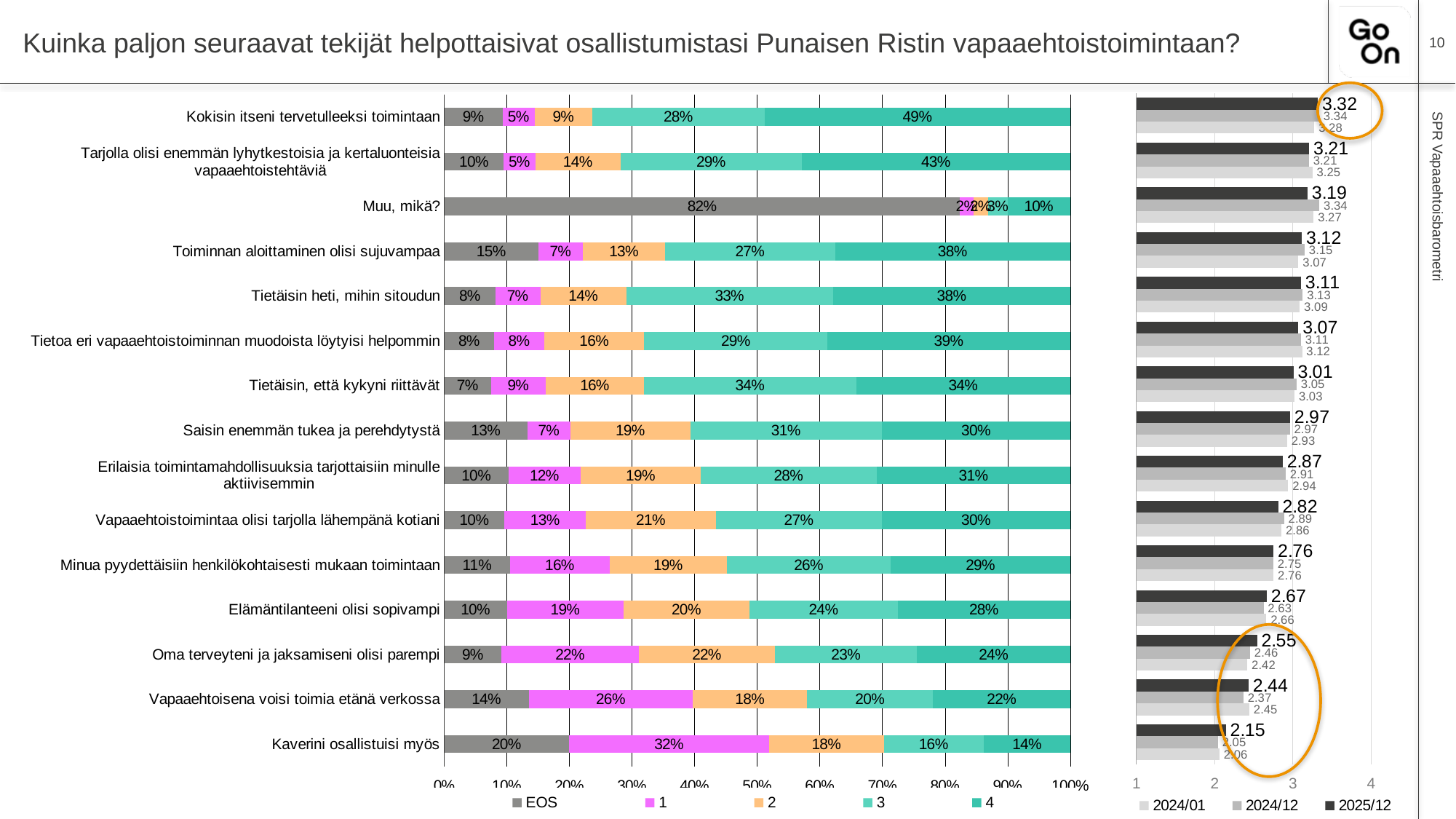
In the left stacked bar chart, what percentage of respondents gave a rating of 4 for "Kokisin itseni tervetulleeksi toimintaan"? 49% In the left stacked bar chart, which category has the highest share of rating 4? Kokisin itseni tervetulleeksi toimintaan What kind of chart is the left chart on the slide? Stacked bar chart In the right bar chart, which category has the lowest 2025/12 value? Kaverini osallistuisi myös In the left stacked bar chart, what percentage gave a rating of 1 for "Kaverini osallistuisi myös"? 32% In the right bar chart, what is the 2025/12 value for "Kokisin itseni tervetulleeksi toimintaan"? 3.32 How many series does the legend of the left stacked bar chart list? 5 How many categories are shown in the left stacked bar chart? 15 In the left stacked bar chart, for "Kaverini osallistuisi myös", which is larger: the share of rating 1 or the share of rating 4? Rating 1 In the left stacked bar chart, what is the EOS share for "Muu, mikä?"? 82% In the left stacked bar chart, what is the difference between the rating-4 share for "Kokisin itseni tervetulleeksi toimintaan" and for "Tarjolla olisi enemmän lyhytkestoisia ja kertaluonteisia vapaaehtoistehtäviä"? 6 percentage points How many series does the legend of the right bar chart list? 3